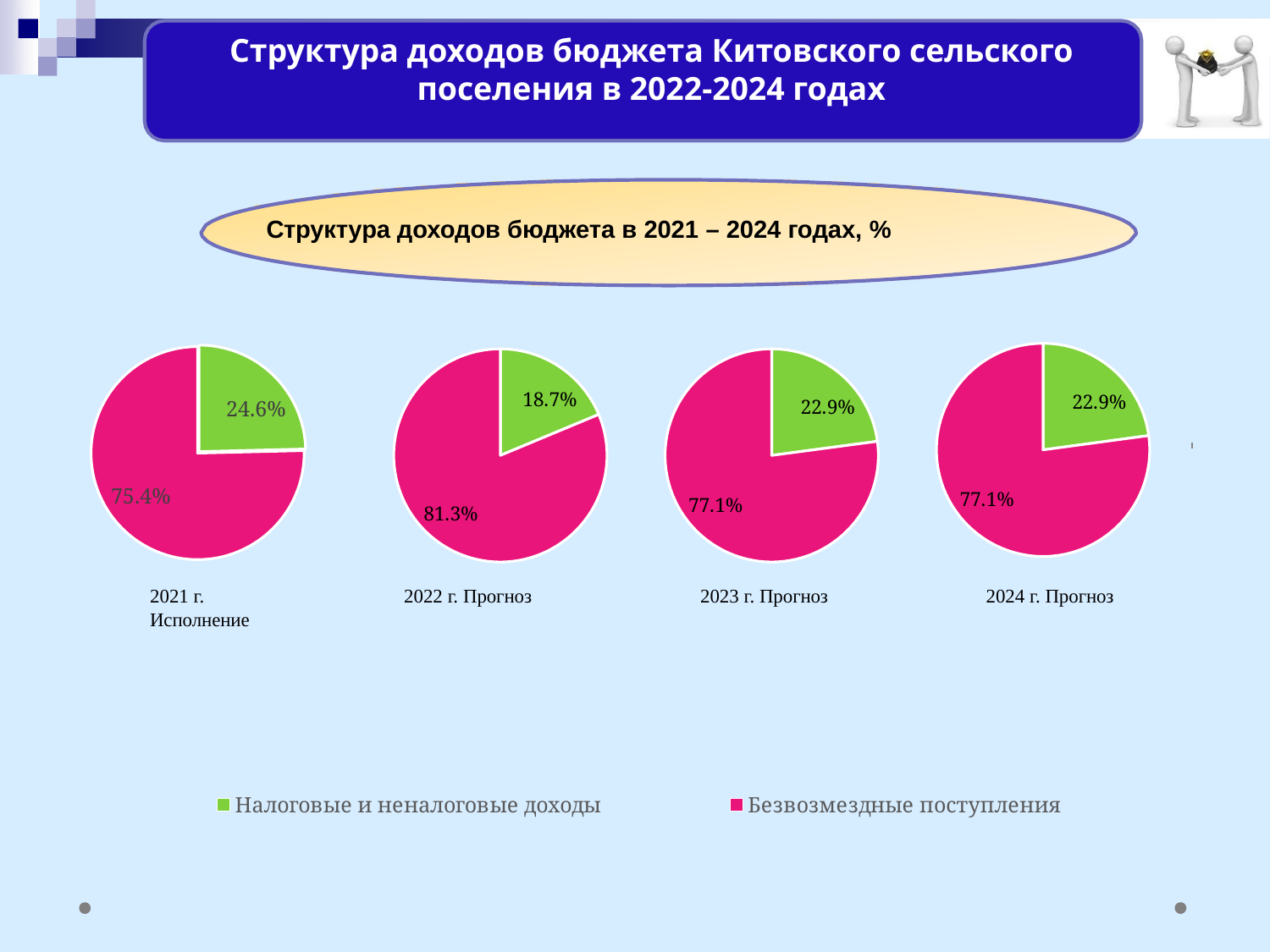
In the pie chart labelled "2021 г. Исполнение", what share is shown for Безвозмездные поступления? 75.4% In the pie chart labelled "2023 г. Прогноз", what share is shown for Безвозмездные поступления? 77.1% Across the four pie charts, which year shows the lowest share for Налоговые и неналоговые доходы? 2022 г. Прогноз In the pie chart labelled "2024 г. Прогноз", what share is shown for Налоговые и неналоговые доходы? 22.9% In the pie chart labelled "2022 г. Прогноз", what share is shown for Налоговые и неналоговые доходы? 18.7% Across the four pie charts, which year shows the highest share for Налоговые и неналоговые доходы? 2021 г. Исполнение In the pie chart labelled "2021 г. Исполнение", what is the difference between the shares of Безвозмездные поступления and Налоговые и неналоговые доходы? 50.8% What type of chart is used on this slide? Pie chart How many categories does the legend list? 2 In the pie chart labelled "2021 г. Исполнение", what share is shown for Налоговые и неналоговые доходы? 24.6% In the pie chart labelled "2022 г. Прогноз", which category has the larger share? Безвозмездные поступления In the pie chart labelled "2022 г. Прогноз", what share is shown for Безвозмездные поступления? 81.3%